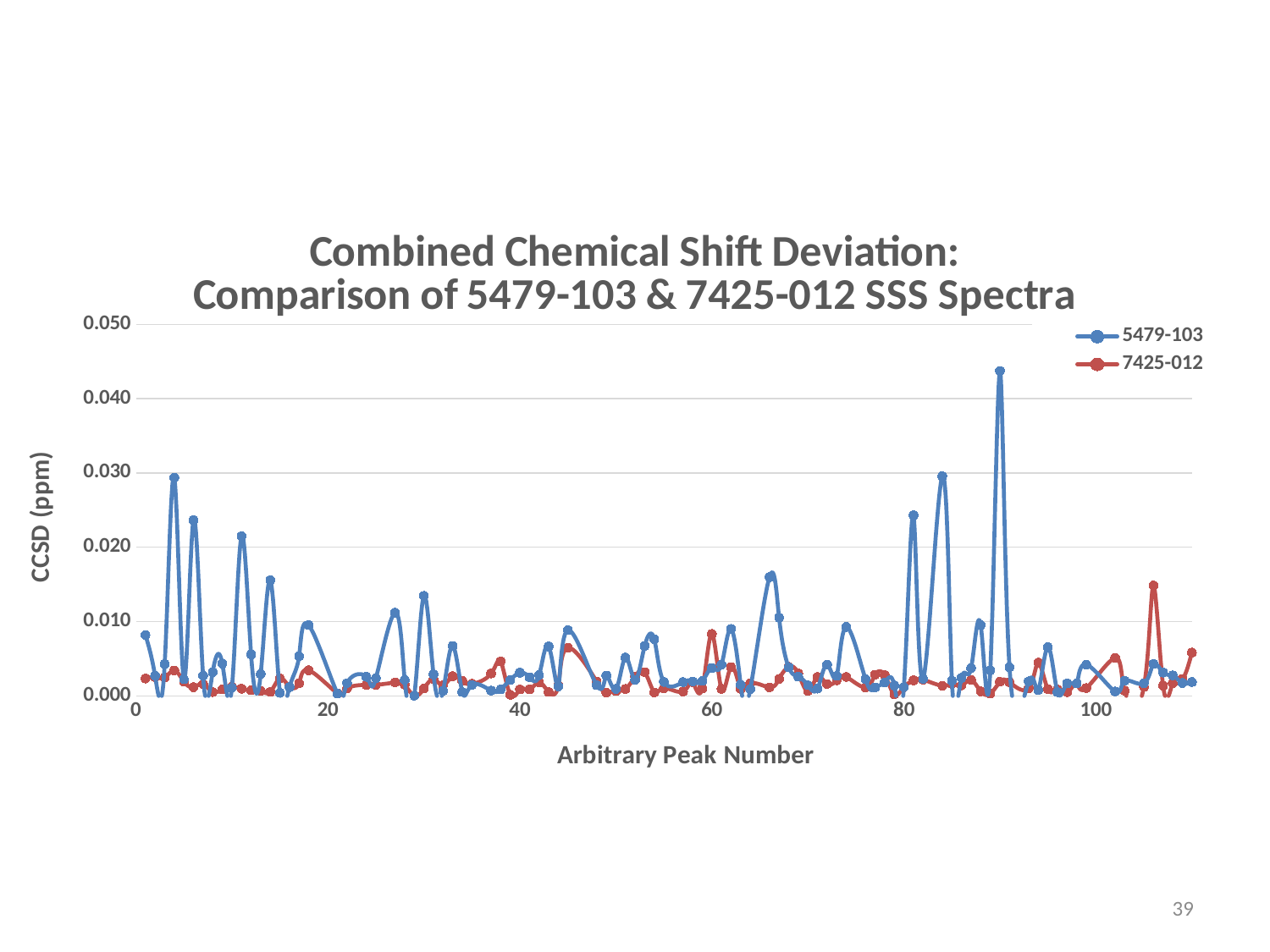
Which series is drawn in red? 7425-012 Which series reaches the highest CCSD value on the chart? 5479-103 What is the label of the y axis? CCSD (ppm) Is the value of the 5479-103 series at peak number 4 greater or less than 0.020? greater Is the highest value of the 5479-103 series greater or less than 0.040? greater Is the highest value of the 7425-012 series greater or less than 0.020? less How many series does the legend list? 2 What kind of chart is shown on the slide? Line chart What is the title of the chart? Combined Chemical Shift Deviation: Comparison of 5479-103 & 7425-012 SSS Spectra Around peak number 90, which series has the larger CCSD value, 5479-103 or 7425-012? 5479-103